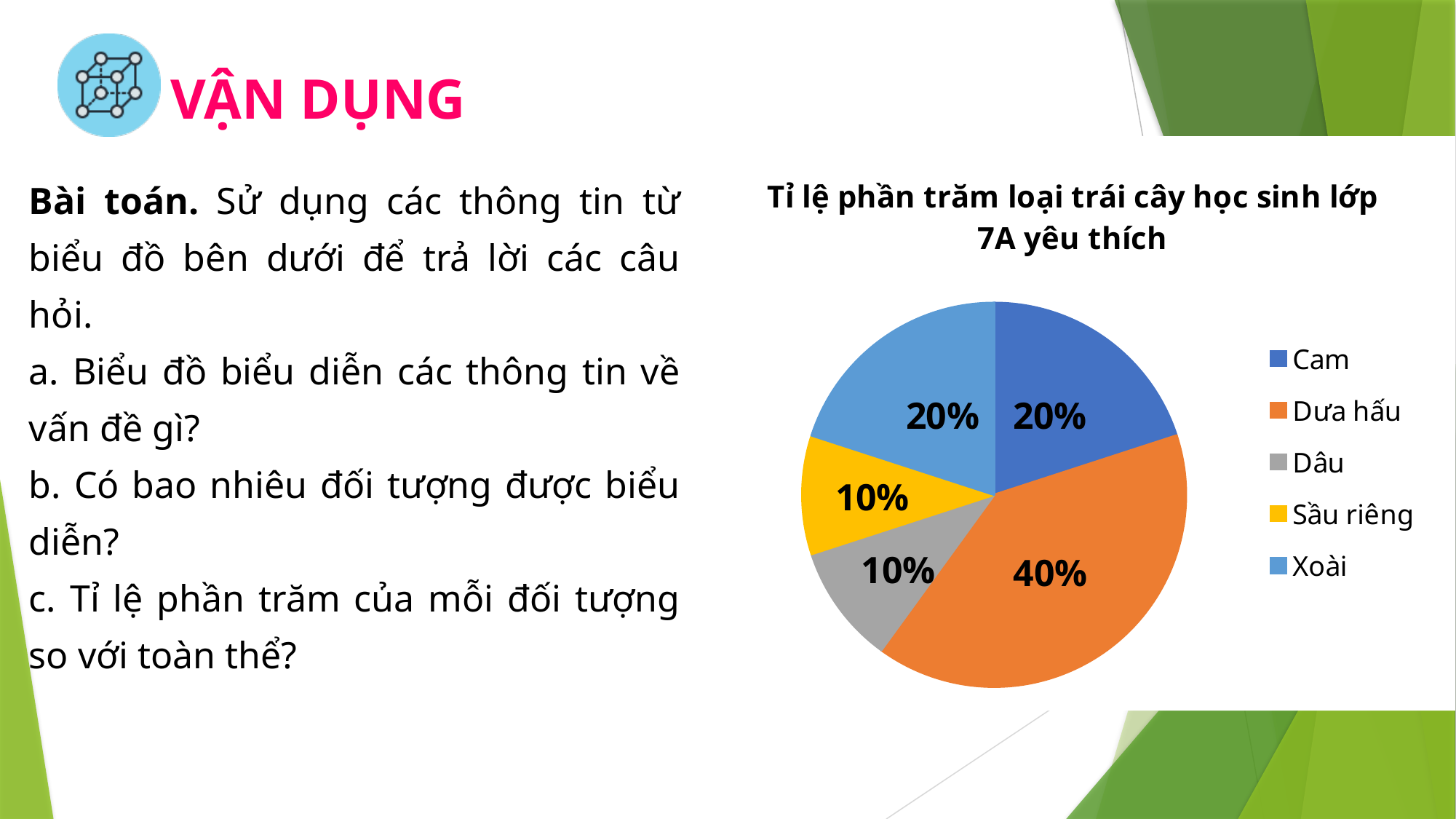
What percentage does the chart show for Sầu riêng? 10% What is the difference in percentage points between Xoài and Sầu riêng? 10% Which fruit has the largest slice of the pie? Dưa hấu How many fruit categories are shown in the pie chart? 5 What percentage does the chart show for Cam? 20% Which is larger, the slice for Dưa hấu or the slice for Cam? Dưa hấu What percentage does the chart show for Dưa hấu? 40% What is the difference in percentage points between Dưa hấu and Dâu? 30% What is the title of the chart? Tỉ lệ phần trăm loại trái cây học sinh lớp 7A yêu thích What share of the pie does Dâu represent? 10% What percentage does the chart show for Xoài? 20% What kind of chart is shown on the slide? Pie chart